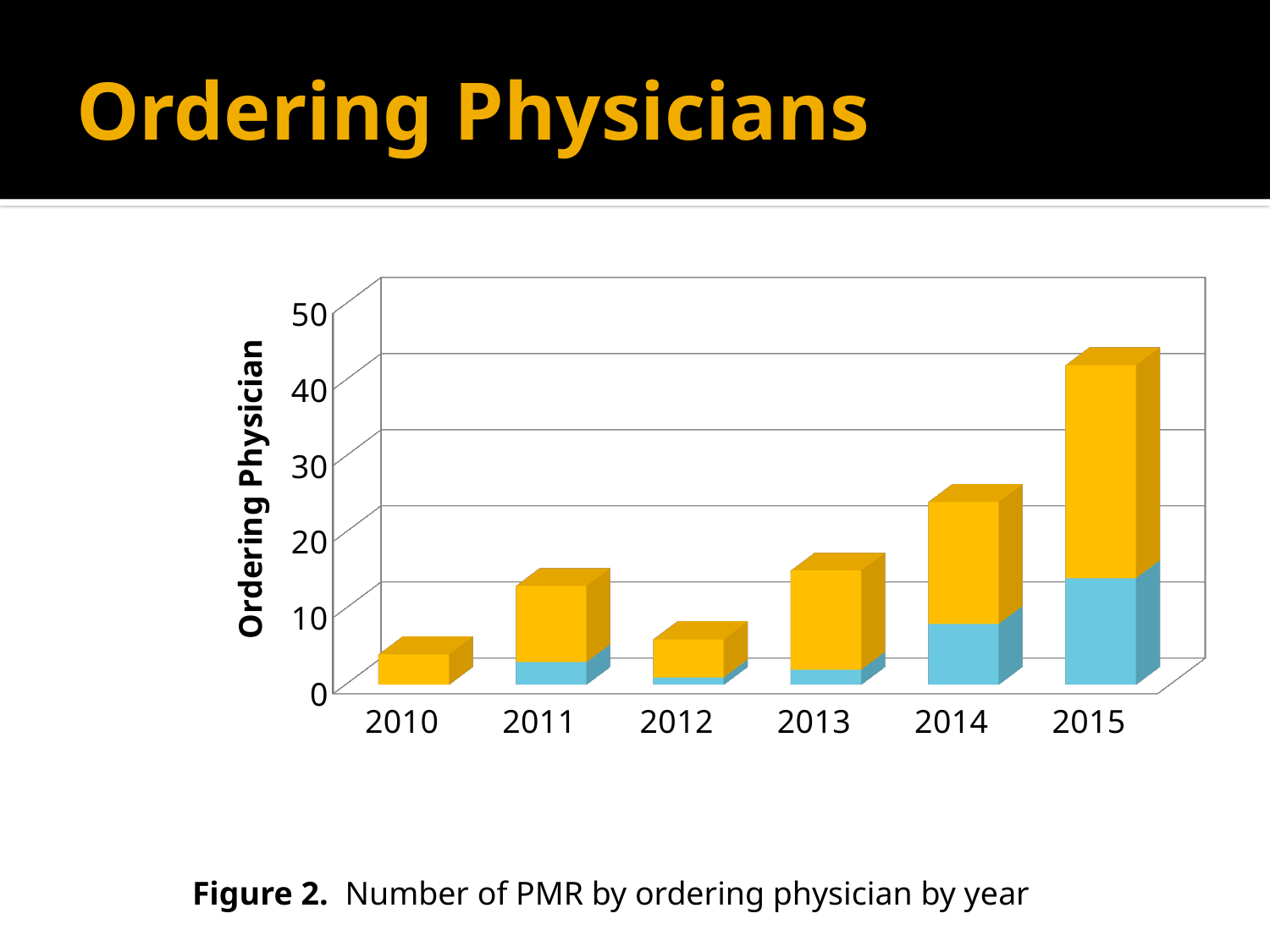
Is the total bar height for 2015 greater or less than 30? greater Which year has the shortest bar in the chart? 2010 Is the total bar height for 2010 greater or less than 10? less What is the label on the vertical axis of the chart? Ordering Physician Which year has the taller bar, 2013 or 2014? 2014 What is the caption given for the chart (Figure 2)? Number of PMR by ordering physician by year Which year has the tallest bar in the chart? 2015 How many years are shown on the x axis of the chart? 6 What kind of chart is shown on the slide? Stacked bar chart Is the total bar height for 2012 greater or less than 10? less Which year has the taller bar, 2011 or 2012? 2011